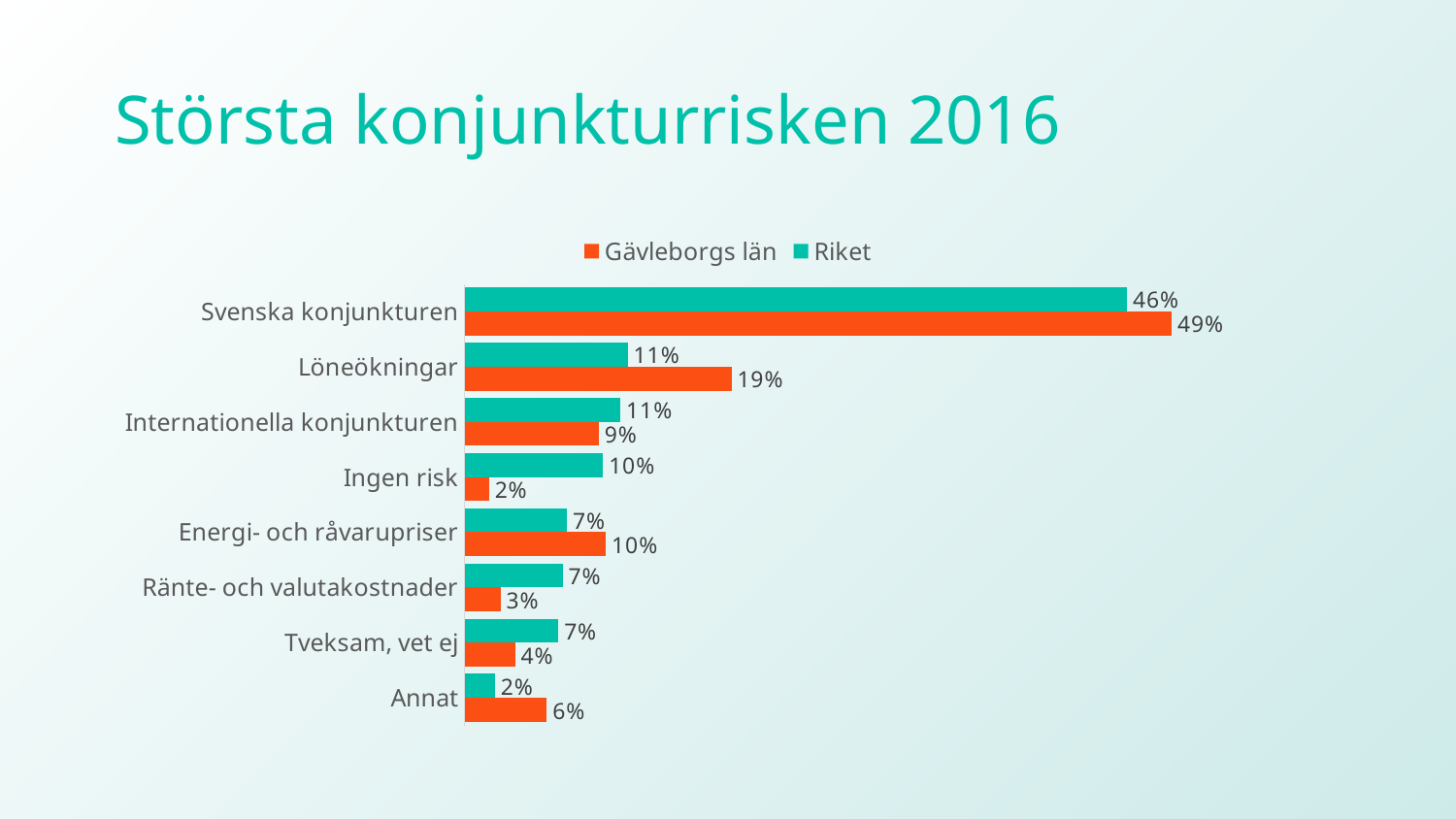
Which is larger for Energi- och råvarupriser, Gävleborgs län or Riket? Gävleborgs län What is the value for Gävleborgs län for Svenska konjunkturen? 49% What is the value for Riket for Löneökningar? 11% What is the difference between Gävleborgs län and Riket for Löneökningar? 8% How many series does the legend list? 2 What is the value for Gävleborgs län for Ingen risk? 2% How many categories are shown in the chart? 8 What is the title of the slide? Största konjunkturrisken 2016 Which category has the highest value for Riket? Svenska konjunkturen Which category has the lowest value for Riket? Annat Which is larger for Ränte- och valutakostnader, Gävleborgs län or Riket? Riket What kind of chart is shown on the slide? bar chart